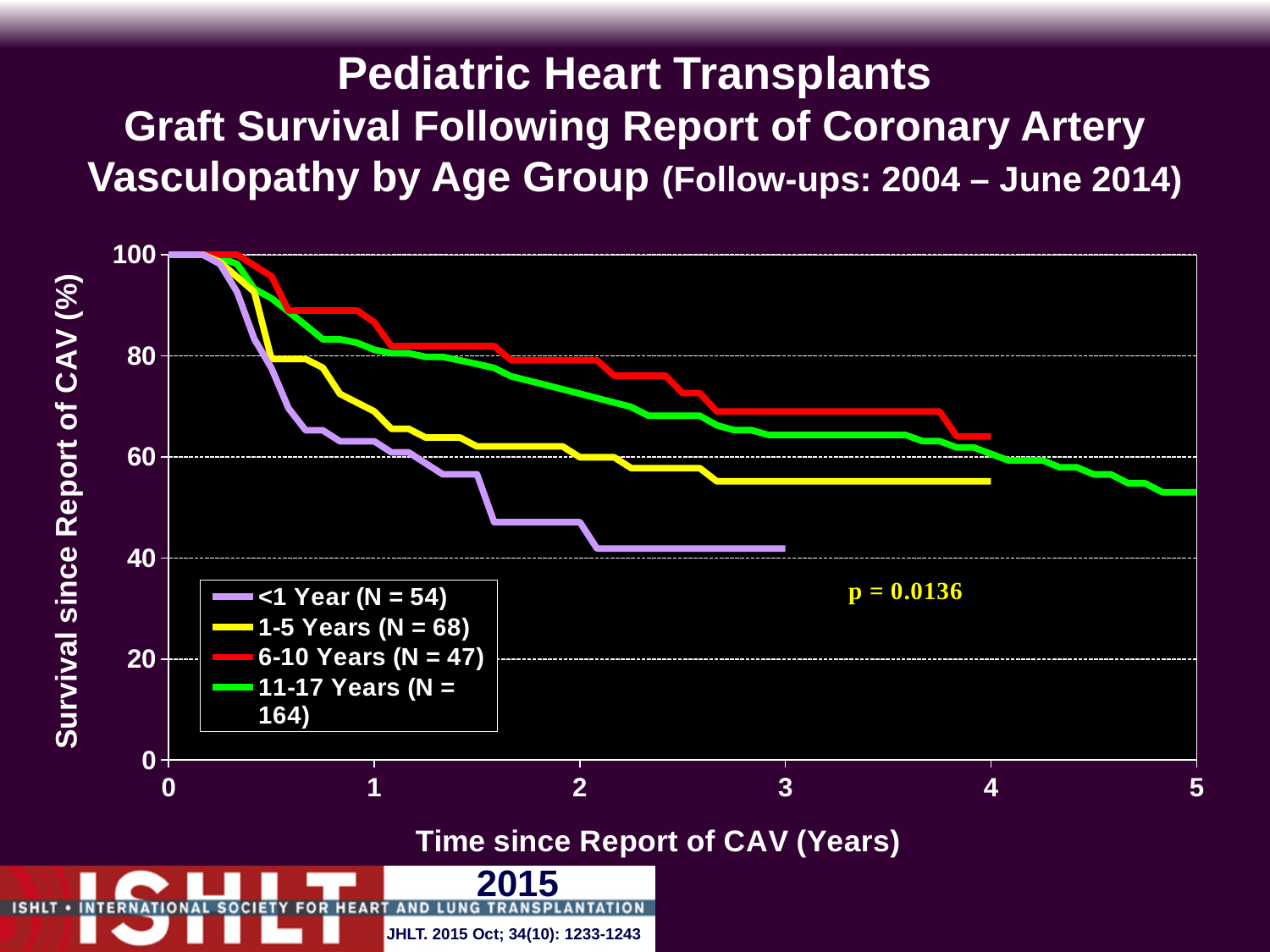
What is the N for the 11-17 Years group in the legend? 164 Is the survival value for the 1-5 Years group at 3 years greater or less than 60? less Is the survival value for the 11-17 Years group at 5 years greater or less than 60? less Do the survival curves rise or fall as time since report of CAV increases? fall Is the survival value for the <1 Year group at 2 years greater or less than 60? less What is the p-value shown on the chart? p = 0.0136 How many series does the legend list? 4 At 2 years since report of CAV, which group has the lowest survival? <1 Year At 2 years since report of CAV, which has higher survival: the 6-10 Years group or the <1 Year group? 6-10 Years What kind of chart is shown on the slide? line chart